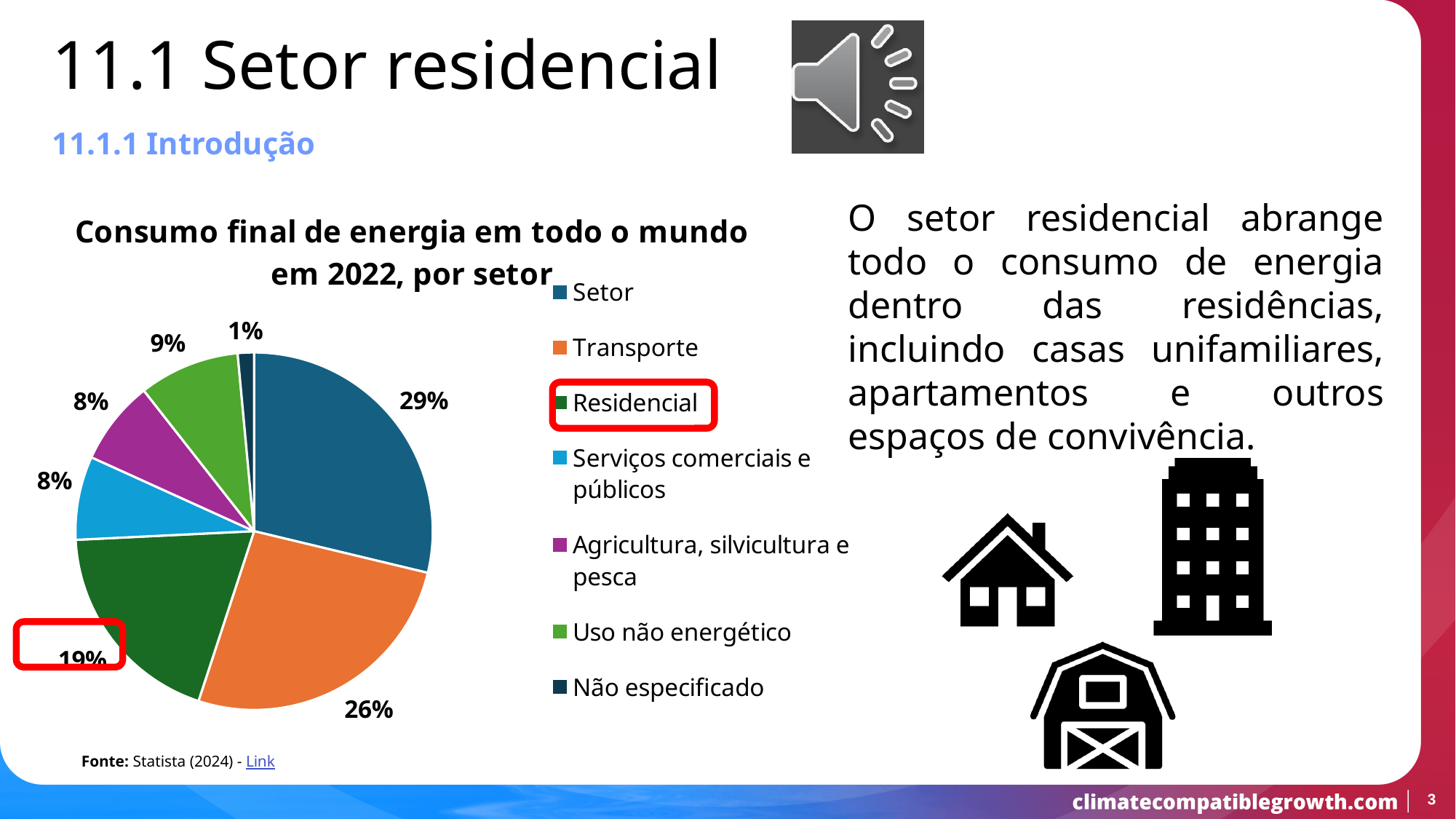
What share of the pie does Não especificado have? 1% What is the title of the chart? Consumo final de energia em todo o mundo em 2022, por setor What is the difference in percentage points between the Transporte slice and the Residencial slice? 7 Which legend entry has the smallest slice of the pie? Não especificado Which legend entry has the largest slice of the pie? Setor What share of the pie does Uso não energético have? 9% What kind of chart is shown on the slide? pie chart What share of the pie does Transporte have? 26% How many entries does the chart legend list? 7 What share of the pie does Residencial have? 19% Which is larger, the Uso não energético slice or the Agricultura, silvicultura e pesca slice? Uso não energético What colour is the Residencial slice in the pie chart? dark green